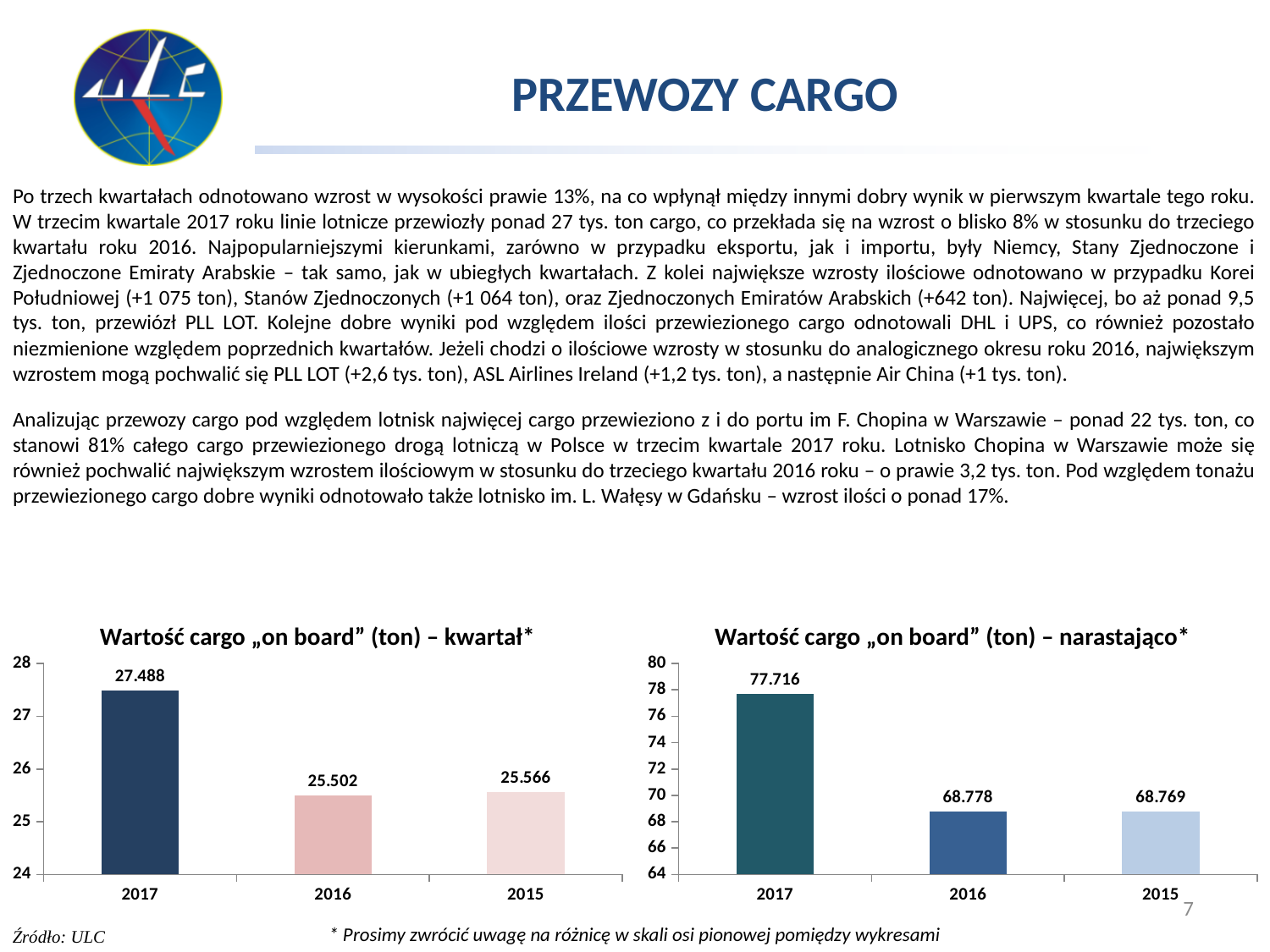
What kind of chart is "Wartość cargo „on board” (ton) – narastająco*"? bar chart In the chart "Wartość cargo „on board” (ton) – kwartał*", is the value for 2016 or 2015 larger? 2015 In the chart "Wartość cargo „on board” (ton) – kwartał*", what is the value for 2016? 25.502 How many years are shown in the chart "Wartość cargo „on board” (ton) – kwartał*"? 3 In the chart "Wartość cargo „on board” (ton) – kwartał*", which year has the lowest value? 2016 In the chart "Wartość cargo „on board” (ton) – narastająco*", which year has the highest value? 2017 In the chart "Wartość cargo „on board” (ton) – narastająco*", what is the value for 2015? 68.769 In the chart "Wartość cargo „on board” (ton) – kwartał*", which year has the highest value? 2017 In the chart "Wartość cargo „on board” (ton) – narastająco*", what is the difference between the values for 2017 and 2016? 8.938 In the chart "Wartość cargo „on board” (ton) – narastająco*", what is the value for 2017? 77.716 In the chart "Wartość cargo „on board” (ton) – narastająco*", is the value for 2016 greater or less than 70? less In the chart "Wartość cargo „on board” (ton) – kwartał*", what is the value for 2017? 27.488